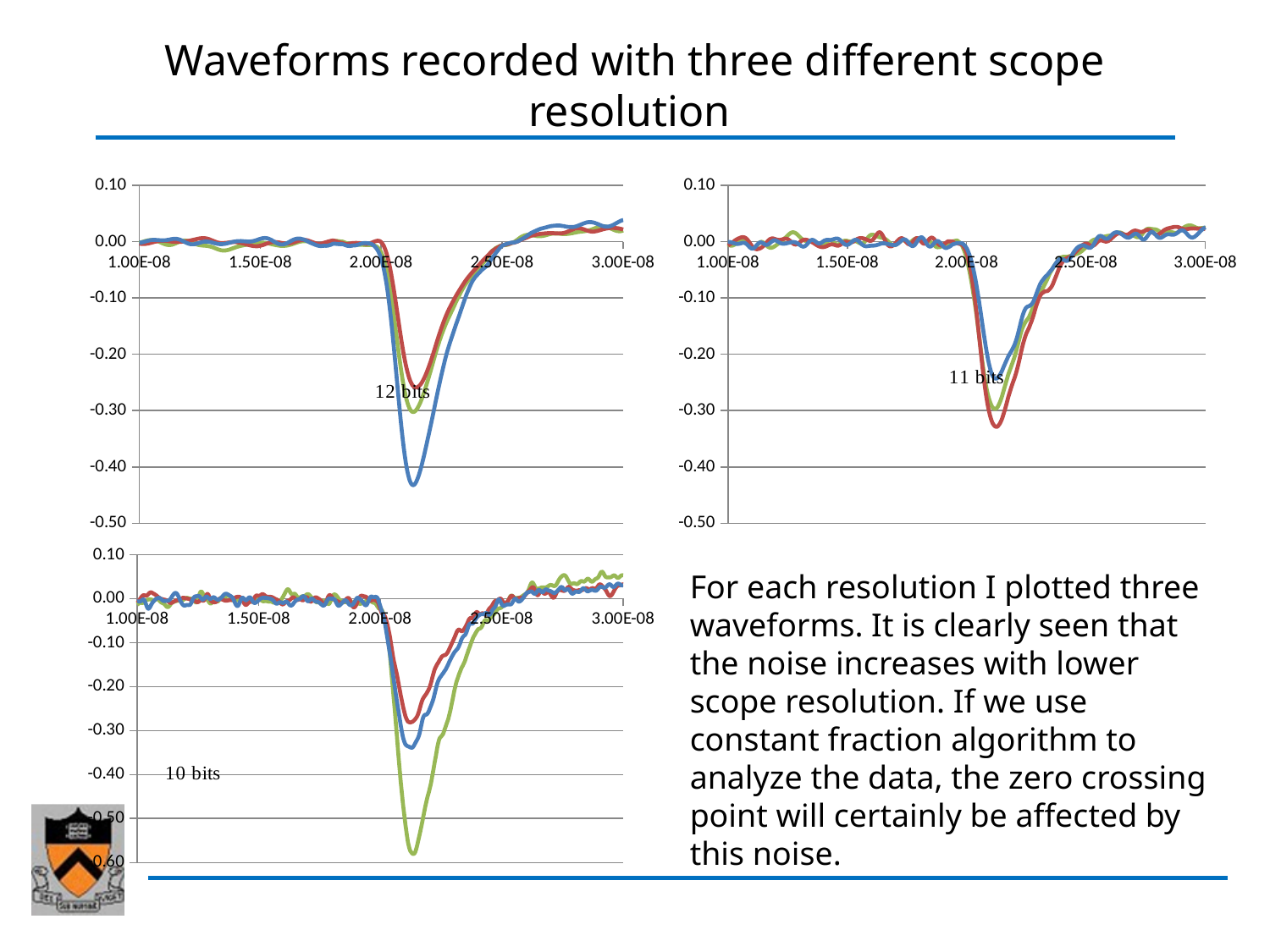
How many charts are shown on the slide? 3 How many waveforms are plotted in the '10 bits' chart at the bottom left? 3 In the '11 bits' chart at the top right, is the minimum value of the blue line greater or less than -0.30? greater In the '10 bits' chart, which coloured line reaches the lowest value? green What is the lowest tick value shown on the y axis of the '10 bits' chart? -0.60 In the '12 bits' chart, is the minimum value of the blue line greater or less than -0.40? less In the '10 bits' chart, which line dips lower, the green line or the red line? green In the '12 bits' chart, is the minimum value of the red line greater or less than -0.30? greater What kind of chart is the '12 bits' chart at the top left of the slide? line chart In the '12 bits' chart, which coloured line reaches the lowest value? blue